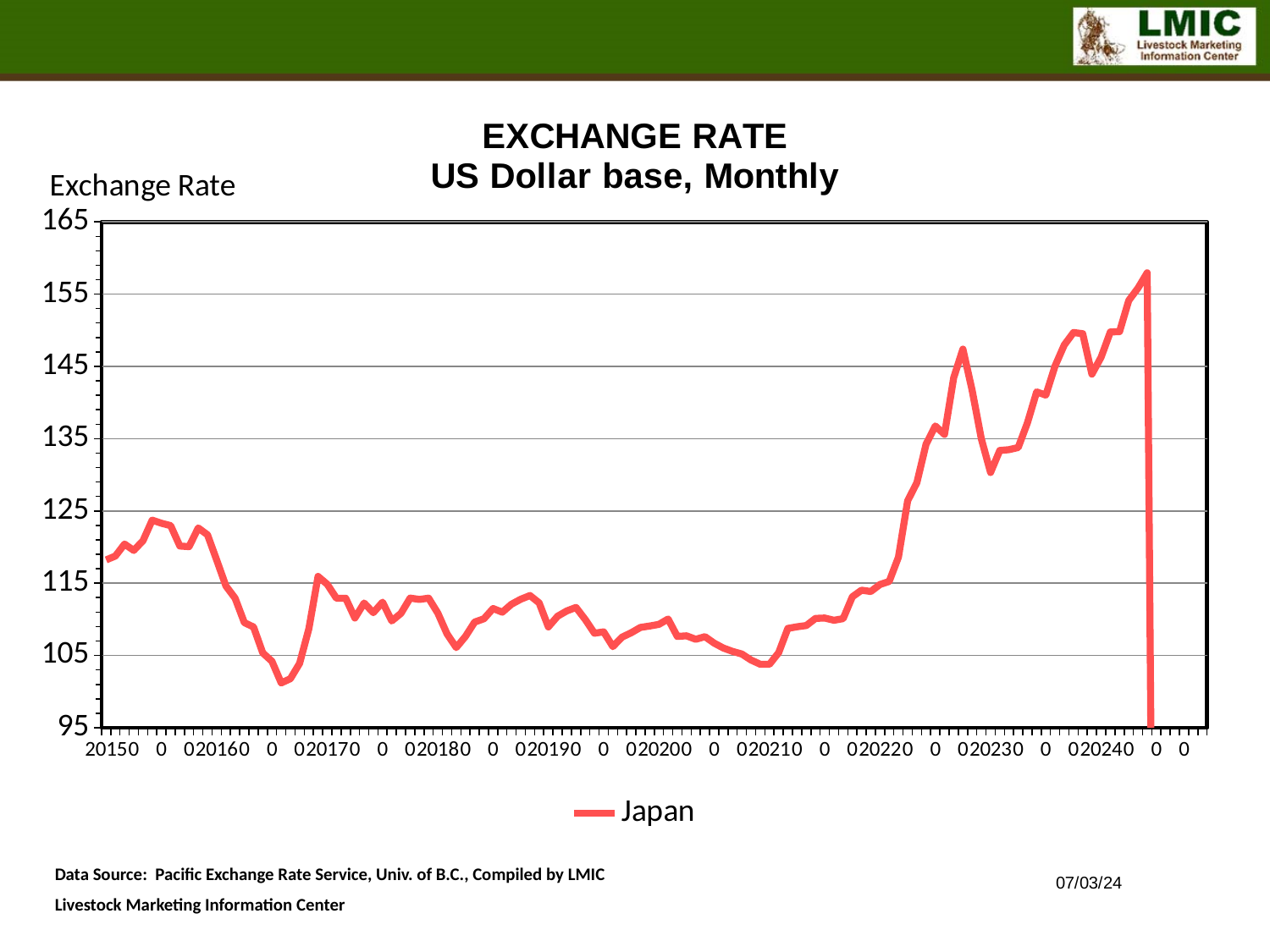
Which country is named in the chart legend? Japan What kind of chart is shown on the slide? line chart Does the Japan exchange rate rise or fall from the start of 2015 to the low point in 2016? fall Is the Japan exchange rate at the start of 2023 greater or less than 125? greater Is the Japan exchange rate at the start of 2020 greater or less than 115? less Does the Japan exchange rate rise or fall from the start of 2021 to its 2024 peak? rise Is the lowest point of the Japan exchange rate in 2016 greater or less than 105? less How many series does the legend list? 1 What is the subtitle of the chart below 'EXCHANGE RATE'? US Dollar base, Monthly In which year does the Japan exchange rate reach its highest value on the chart? 2024